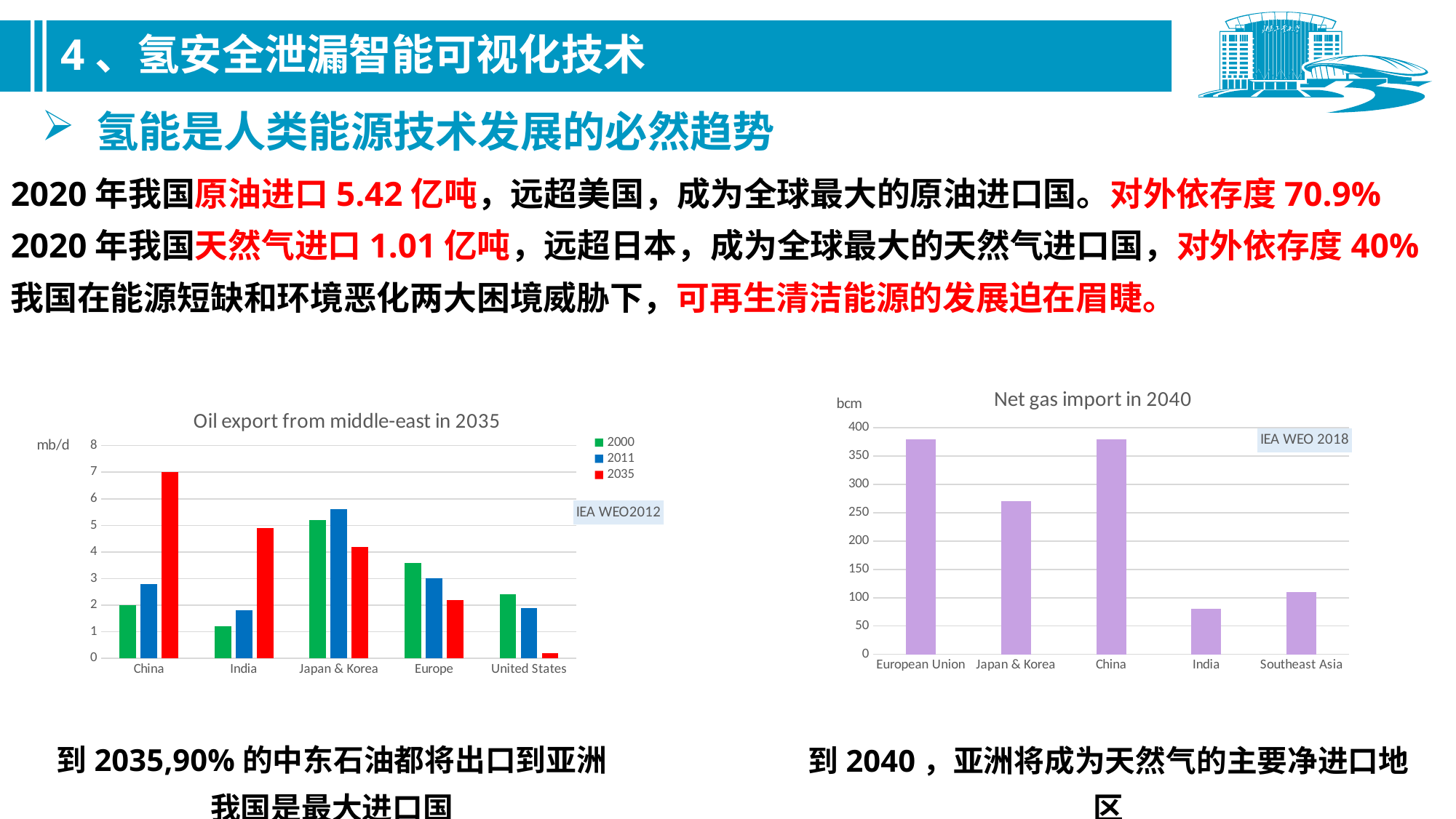
How many categories are shown on the x axis of the 'Oil export from middle-east in 2035' chart? 5 In the 'Net gas import in 2040' chart, is the value for Japan & Korea greater or less than 250? greater What is the unit shown on the y axis of the 'Net gas import in 2040' chart? bcm In the 'Net gas import in 2040' chart, which category has the lowest value? India In the 'Oil export from middle-east in 2035' chart, do the values for the United States rise or fall from 2000 to 2035? fall In the 'Oil export from middle-east in 2035' chart, which category has the lowest 2035 value? United States What kind of chart is the 'Oil export from middle-east in 2035' chart? bar chart In the 'Net gas import in 2040' chart, is the value for India greater or less than 100? less How many series does the legend of the 'Oil export from middle-east in 2035' chart list? 3 In the 'Oil export from middle-east in 2035' chart, is the 2035 value for China greater or less than 6? greater In the 'Oil export from middle-east in 2035' chart, which category has the highest 2035 value? China In the 'Oil export from middle-east in 2035' chart, which is larger for Japan & Korea: the 2000 value or the 2035 value? 2000